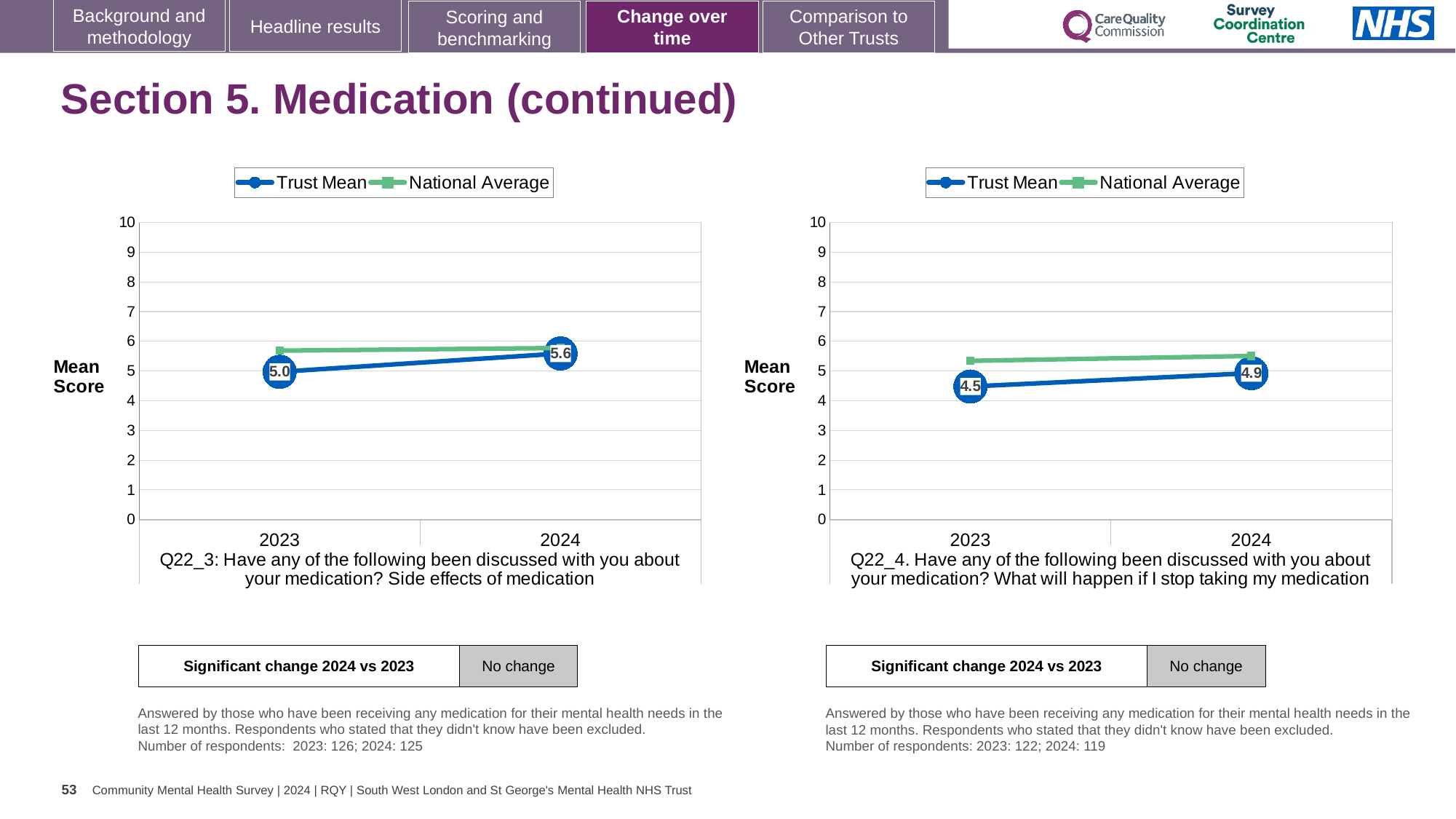
In the left chart (Q22_3), does the Trust Mean rise or fall from 2023 to 2024? rise In the left chart (Q22_3), is the National Average for 2023 greater or less than 5? greater In the right chart (Q22_4), what is the difference between the Trust Mean in 2024 and 2023? 0.4 In the right chart (Q22_4), what is the Trust Mean score for 2023? 4.5 In the left chart (Q22_3), what is the Trust Mean score for 2024? 5.6 How many years are shown on the x axis of the left chart (Q22_3)? 2 In the left chart (Q22_3), what is the Trust Mean score for 2023? 5.0 In the left chart (Q22_3), by how much did the Trust Mean change from 2023 to 2024? 0.6 What kind of chart is used for Q22_4 on the right? line chart In the right chart (Q22_4), which is higher in 2023, the Trust Mean or the National Average? National Average In the right chart (Q22_4), what is the Trust Mean score for 2024? 4.9 How many series does the legend of the right chart (Q22_4) list? 2